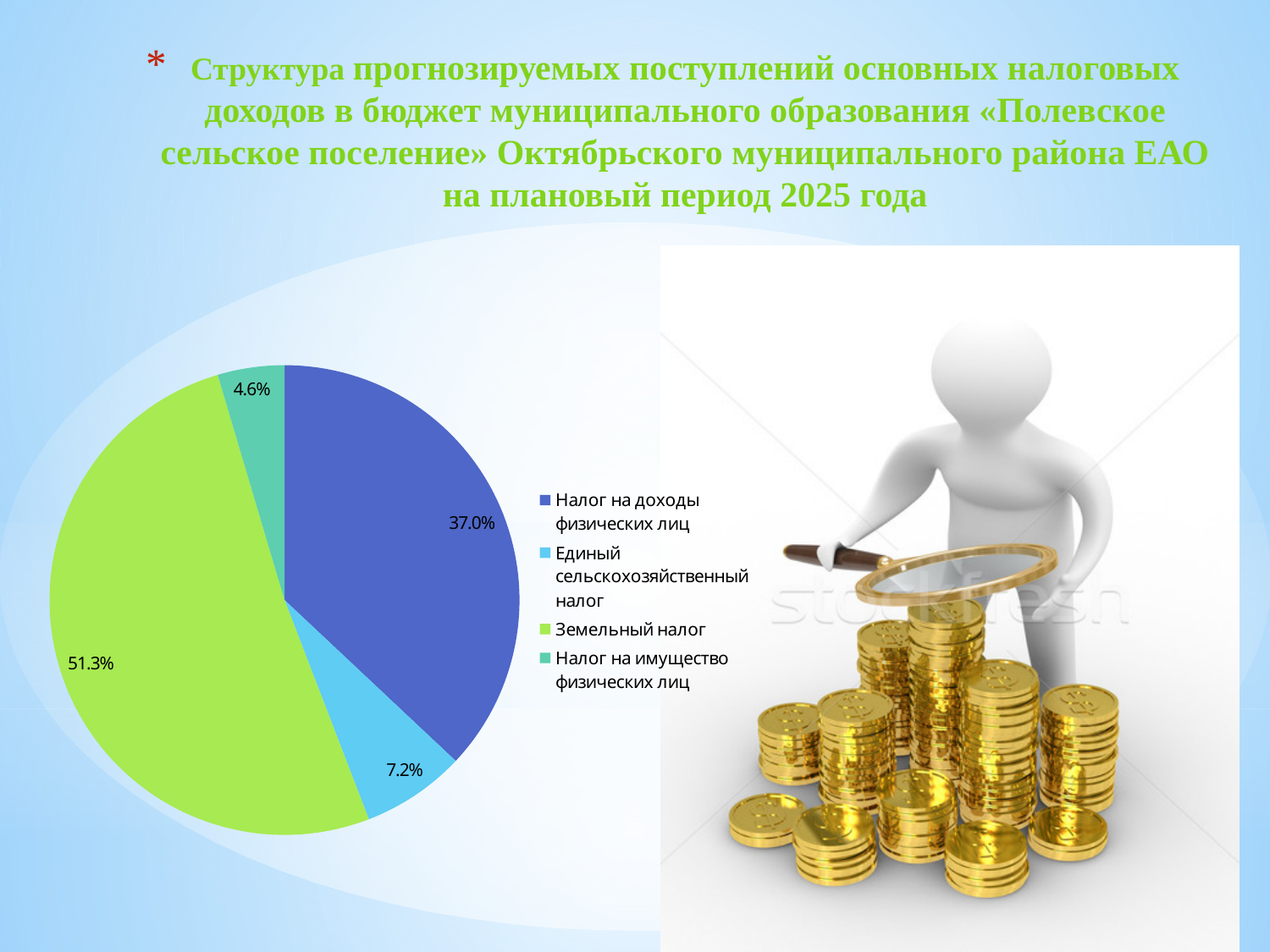
What colour is the slice for Земельный налог? green How many categories does the pie chart have? 4 What type of chart is shown on the slide? pie chart What is the value shown for Налог на имущество физических лиц? 4.6% Which category has the smallest slice of the pie? Налог на имущество физических лиц What share of the pie does Земельный налог have? 51.3% What is the difference between the shares of Земельный налог and Налог на доходы физических лиц? 14.3% What is the value shown for Налог на доходы физических лиц? 37.0% What is the value shown for Единый сельскохозяйственный налог? 7.2% How many entries does the legend list? 4 Which is larger: the share of Единый сельскохозяйственный налог or the share of Налог на имущество физических лиц? Единый сельскохозяйственный налог Which category has the largest slice of the pie? Земельный налог